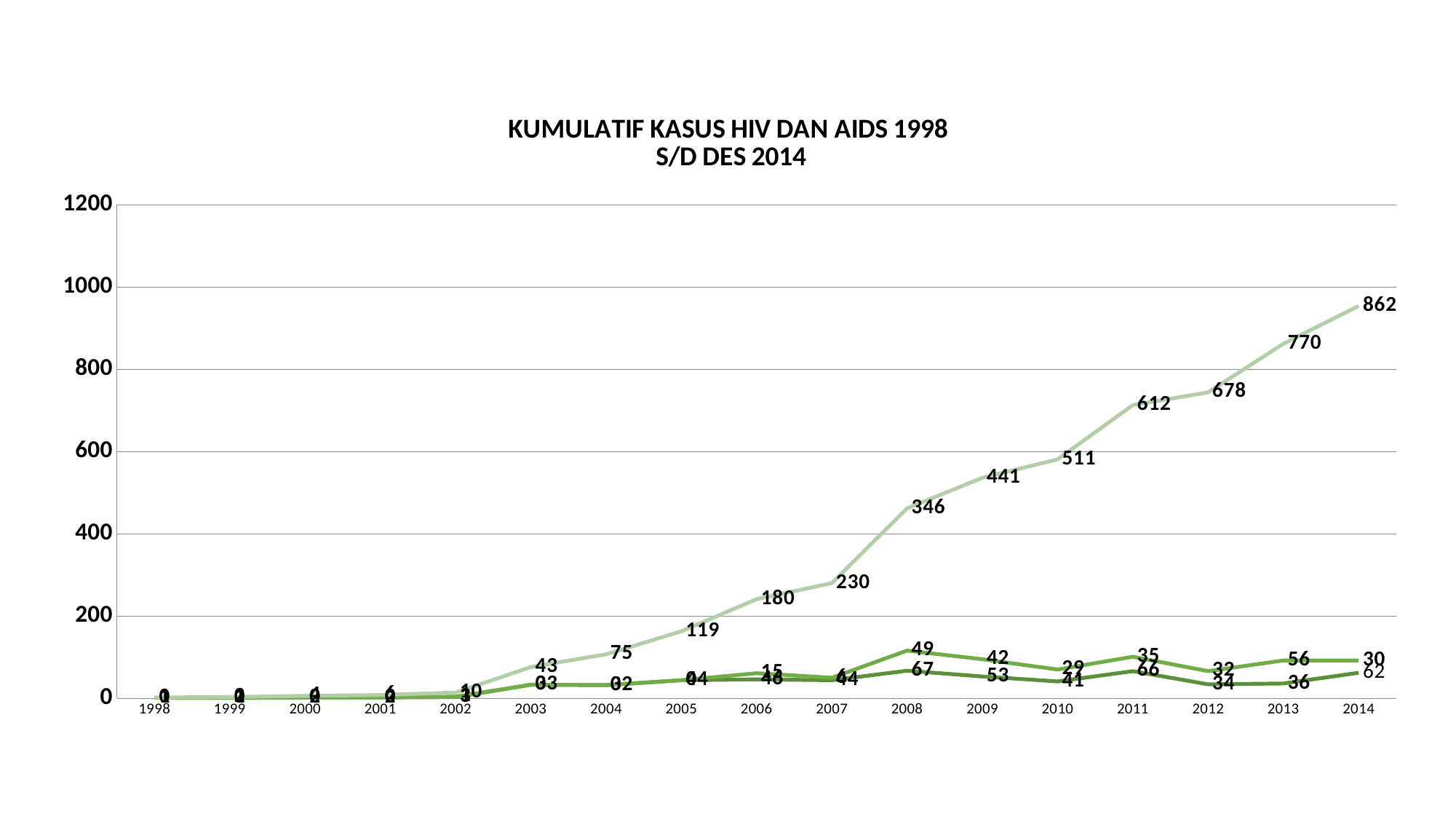
What is the difference between the topmost line's values in 2011 and 2010? 101 What is the title of the chart? KUMULATIF KASUS HIV DAN AIDS 1998 S/D DES 2014 Does the topmost line rise or fall from 2003 to 2014? rise How many years are shown along the x axis? 17 What type of chart is shown on the slide? line chart Which is larger for the topmost line: the value in 2009 or the value in 2007? 2009 In which year does the topmost line reach its highest value? 2014 What is the value of the topmost line in 2014? 862 What is the value of the topmost line in 2008? 346 Is the value of the topmost line in 2012 greater or less than 600? greater What is the value of the topmost line in 2005? 119 What is the difference between the topmost line's values in 2014 and 2013? 92